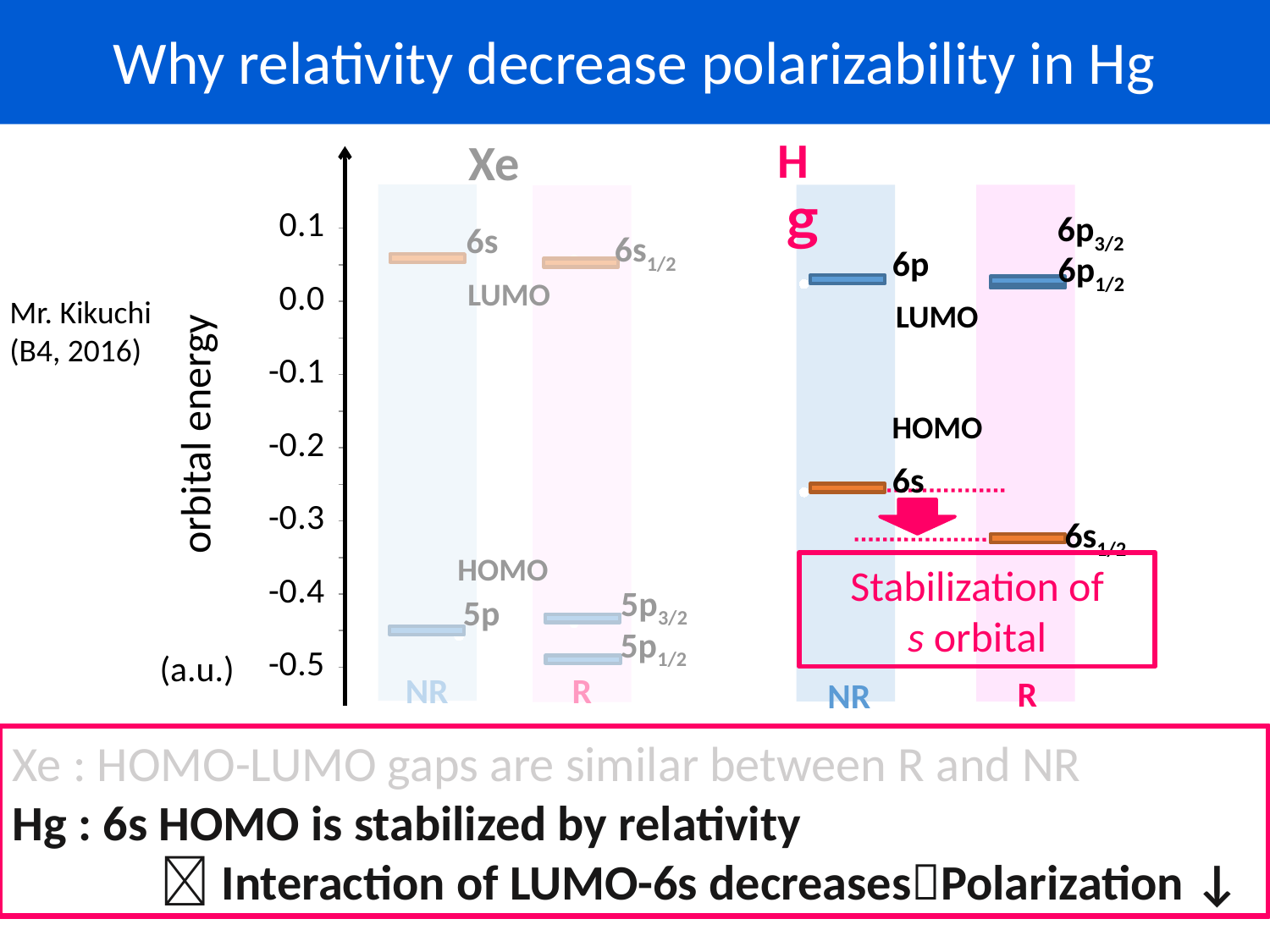
How many orbital levels are drawn in the Hg R panel? 3 In the Hg NR panel, is the orbital energy of the 6p level greater or less than 0.0? greater In the Hg R panel, is the orbital energy of the 6s1/2 level greater or less than -0.3? less Which has the higher orbital energy: the Hg NR 6s level or the Hg R 6s1/2 level? Hg NR 6s In the Xe NR panel, is the orbital energy of the 5p level greater or less than -0.4? less What unit is shown for the orbital energy axis? a.u. Which has the higher orbital energy: the Xe NR 6s level or the Hg NR 6p level? Xe NR 6s In the Xe R panel, which has the higher orbital energy: 5p3/2 or 5p1/2? 5p3/2 How many orbital levels are drawn in the Xe R panel? 3 What is the label on the vertical axis of the diagram? orbital energy